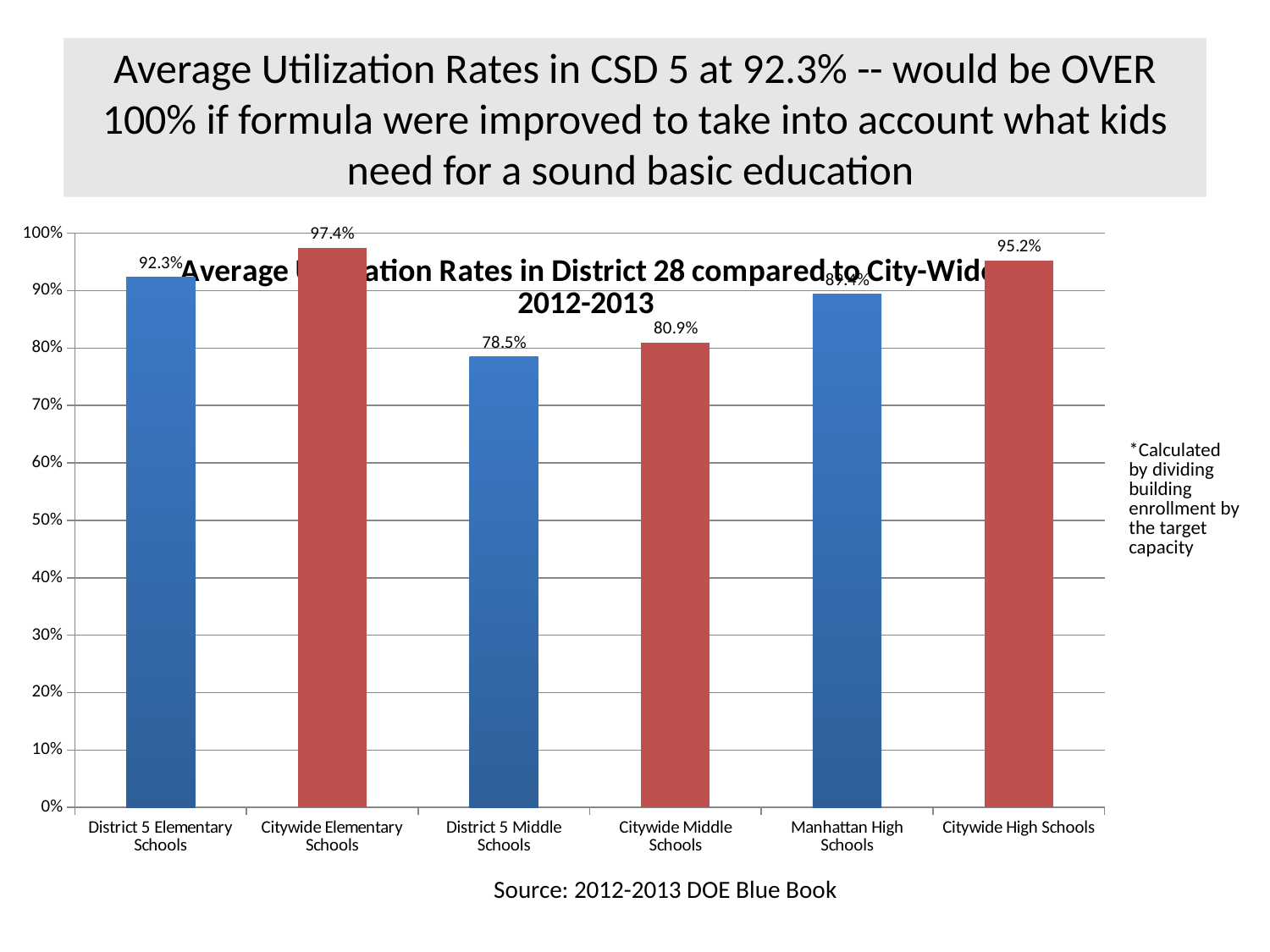
What is the value for Citywide Middle Schools? 80.9% How many categories are shown on the x axis? 6 Which category has the highest value? Citywide Elementary Schools What is the value for District 5 Middle Schools? 78.5% What is the value for District 5 Elementary Schools? 92.3% What is the value for Citywide High Schools? 95.2% What is the difference between Citywide Elementary Schools and District 5 Elementary Schools? 5.1% Is the value for Manhattan High Schools greater or less than 80%? greater Which is larger, Citywide Middle Schools or District 5 Middle Schools? Citywide Middle Schools Which category has the lowest value? District 5 Middle Schools What kind of chart is this? bar chart What is the value for Citywide Elementary Schools? 97.4%